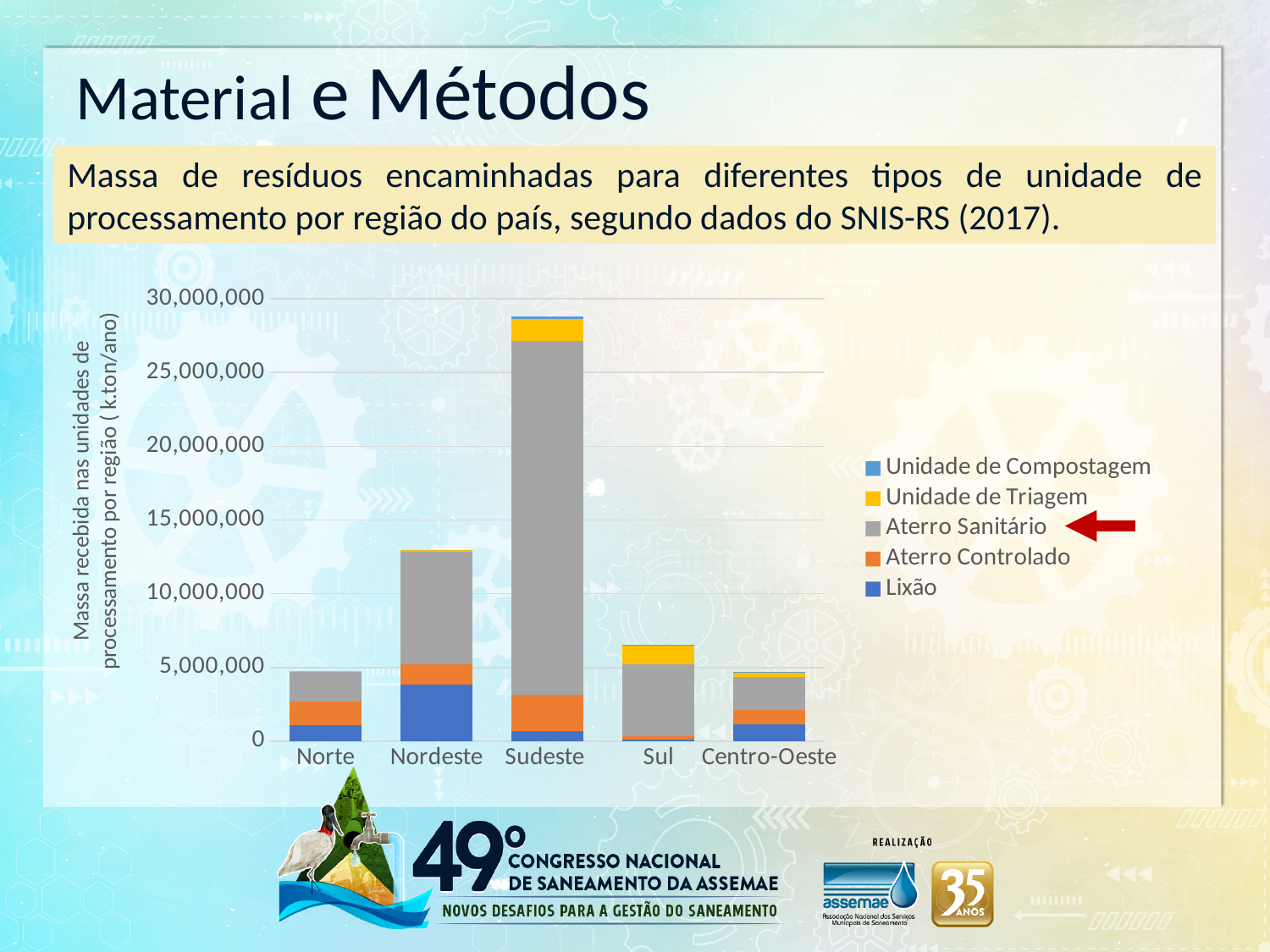
Which has the larger total stacked bar, Sudeste or Nordeste? Sudeste Is the total stacked value for Sul greater or less than 5,000,000? greater Which has the larger total stacked bar, Nordeste or Sul? Nordeste Is the total stacked value for Sudeste greater or less than 25,000,000? greater Is the total stacked value for Norte greater or less than 10,000,000? less What colour represents the Aterro Sanitário series in the chart? gray How many regions are shown on the x axis of the chart? 5 How many series does the chart legend list? 5 What kind of chart is shown on the slide? stacked bar chart Which legend entry is the red arrow pointing to? Aterro Sanitário Which region has the highest total stacked bar? Sudeste